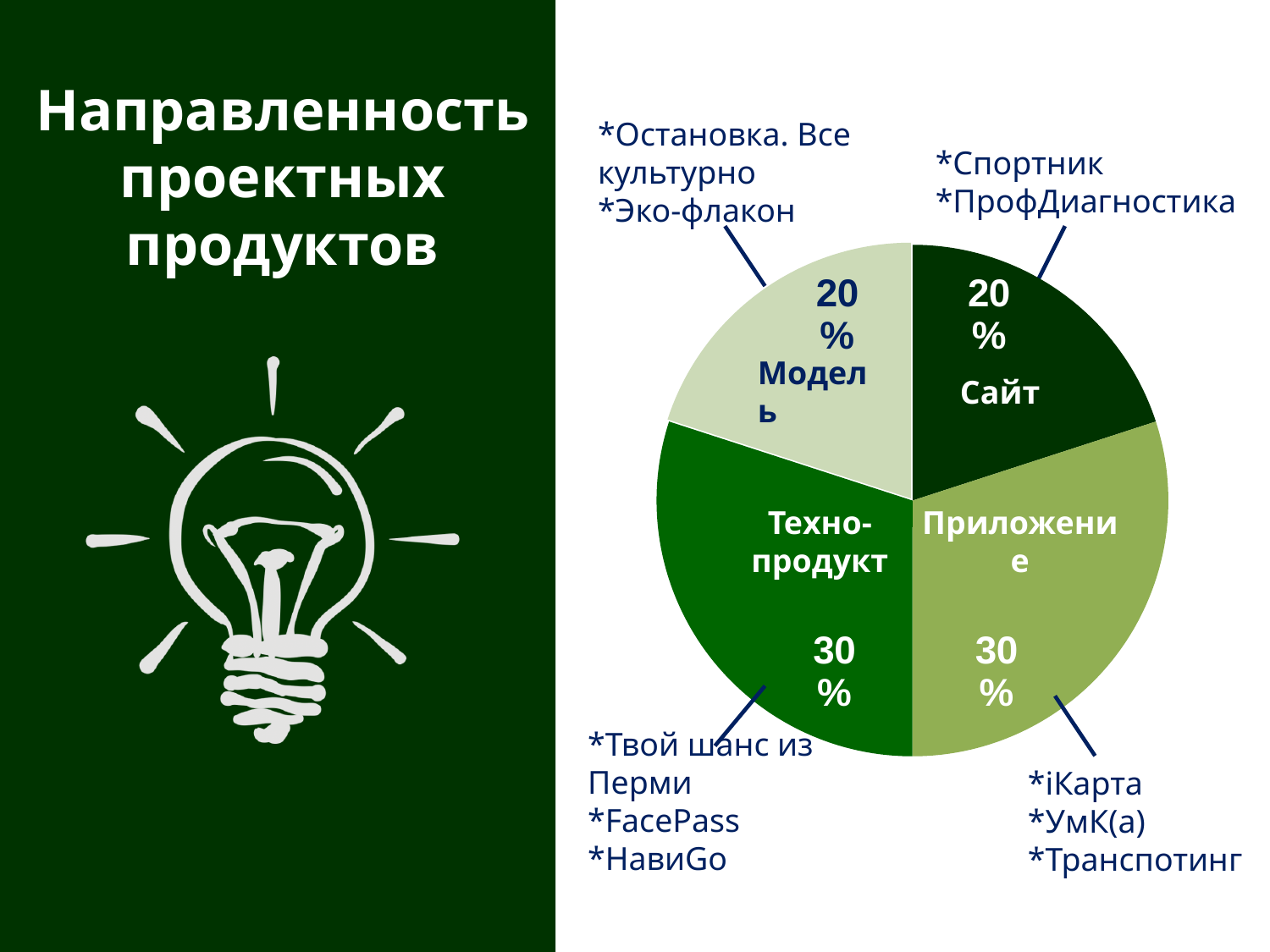
Which slice is larger, "Сайт" or "Приложение"? Приложение What is the title shown on the slide for the chart? Направленность проектных продуктов What share of the pie does the "Приложение" slice represent? 30% What share of the pie does the "Техно-продукт" slice represent? 30% What is the combined share of the "Техно-продукт" and "Приложение" slices? 60% Which slice is larger, "Модель" or "Техно-продукт"? Техно-продукт Which projects are listed next to the "Сайт" slice? Спортник, ПрофДиагностика How many slices does the pie chart have? 4 What kind of chart is shown on the slide? pie chart What share of the pie does the "Сайт" slice represent? 20% What is the difference between the "Техно-продукт" share and the "Сайт" share? 10%